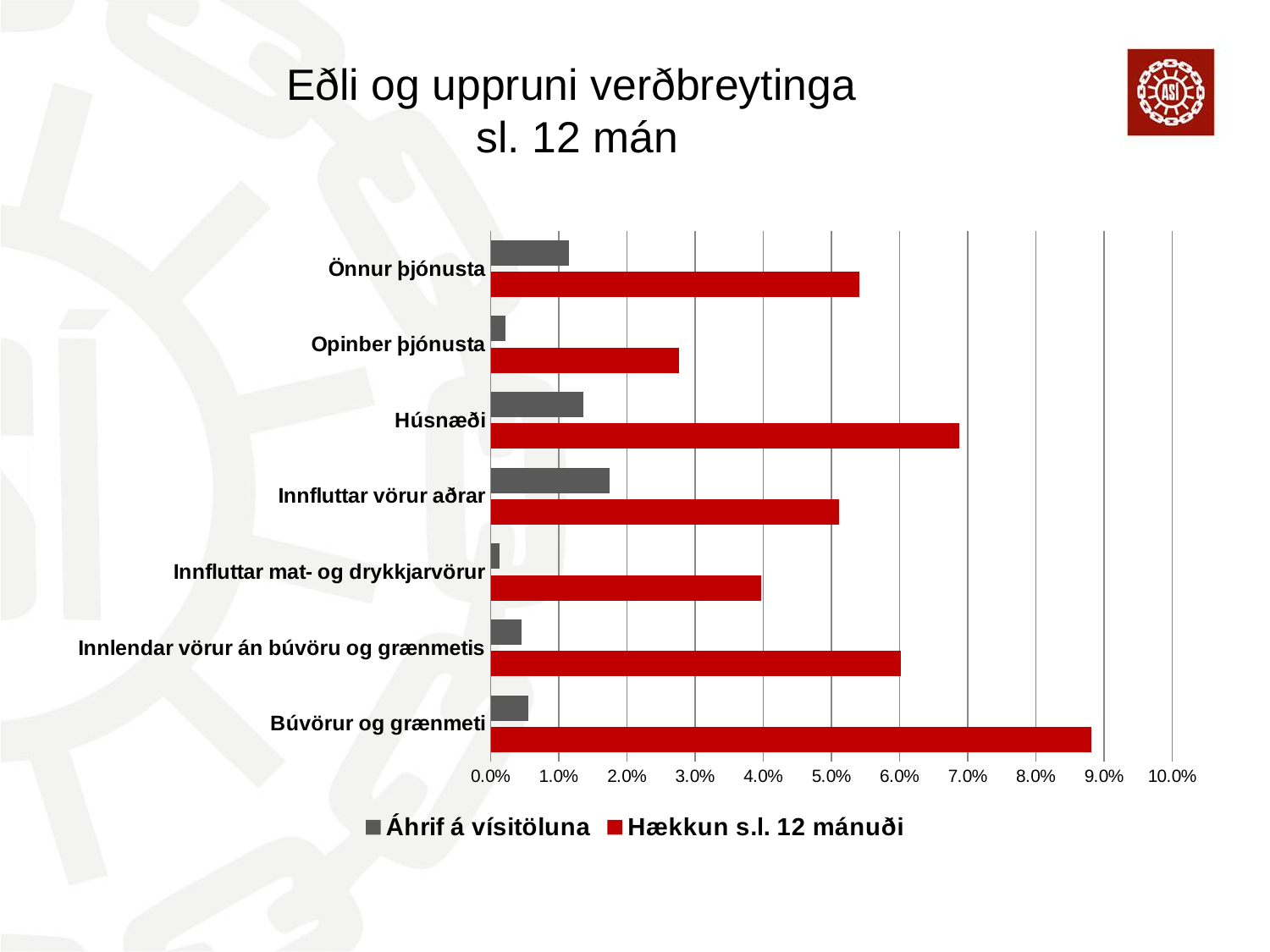
How many categories are shown on the chart? 7 What kind of chart is shown on the slide? bar chart Which has the larger Hækkun s.l. 12 mánuði value, Innlendar vörur án búvöru og grænmetis or Innfluttar mat- og drykkjarvörur? Innlendar vörur án búvöru og grænmetis Which category has the highest value for Hækkun s.l. 12 mánuði? Búvörur og grænmeti Which category has the highest value for Áhrif á vísitöluna? Innfluttar vörur aðrar Which category has the lowest value for Hækkun s.l. 12 mánuði? Opinber þjónusta Which colour represents the series Hækkun s.l. 12 mánuði in the legend? red Which has the larger Hækkun s.l. 12 mánuði value, Húsnæði or Önnur þjónusta? Húsnæði Is the Hækkun s.l. 12 mánuði value for Opinber þjónusta greater or less than 3.0%? less How many series does the legend list? 2 Is the Hækkun s.l. 12 mánuði value for Húsnæði greater or less than 6.0%? greater Is the Hækkun s.l. 12 mánuði value for Búvörur og grænmeti greater or less than 8.0%? greater